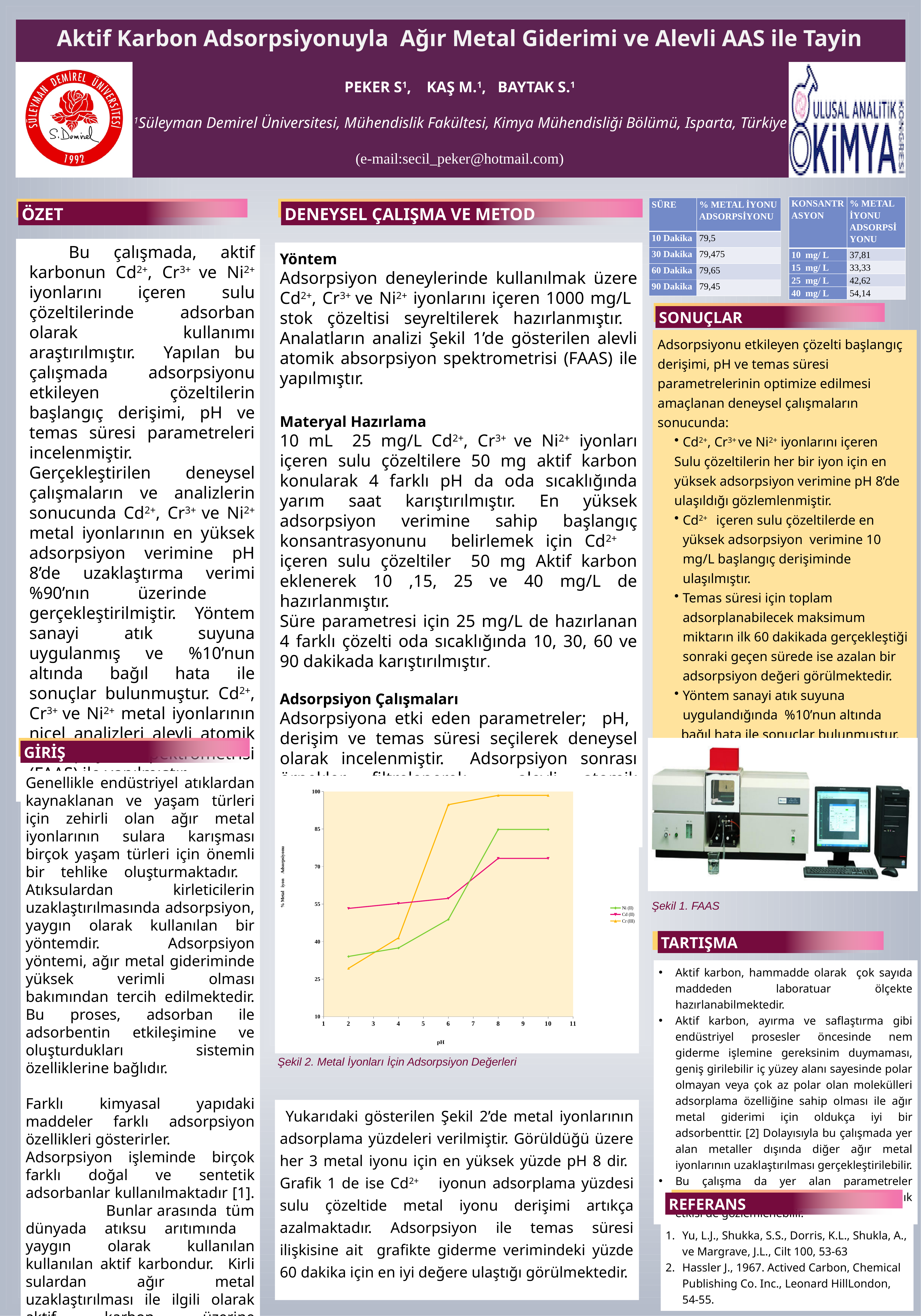
What are the legend entries in Şekil 2? Ni (II), Cd (II), Cr (III) What kind of chart is Şekil 2 (Metal İyonları İçin Adsorpsiyon Değerleri)? line chart How many series does the legend of Şekil 2 list? 3 In Şekil 2, which series has the lowest value at pH 10? Cd (II) In Şekil 2, which series has the highest value at pH 10? Cr (III) In Şekil 2, at pH 2, which is larger: Cd (II) or Ni (II)? Cd (II) What is the label of the x axis in Şekil 2? pH In Şekil 2, at pH 8, which is larger: Cr (III) or Ni (II)? Cr (III) In Şekil 2, is the value for Cr (III) at pH 8 greater or less than 85? greater In Şekil 2, is the value for Ni (II) at pH 2 greater or less than 40? less How many data points does each series in Şekil 2 have? 5 In Şekil 2, does the Cr (III) series rise or fall as pH increases? rise